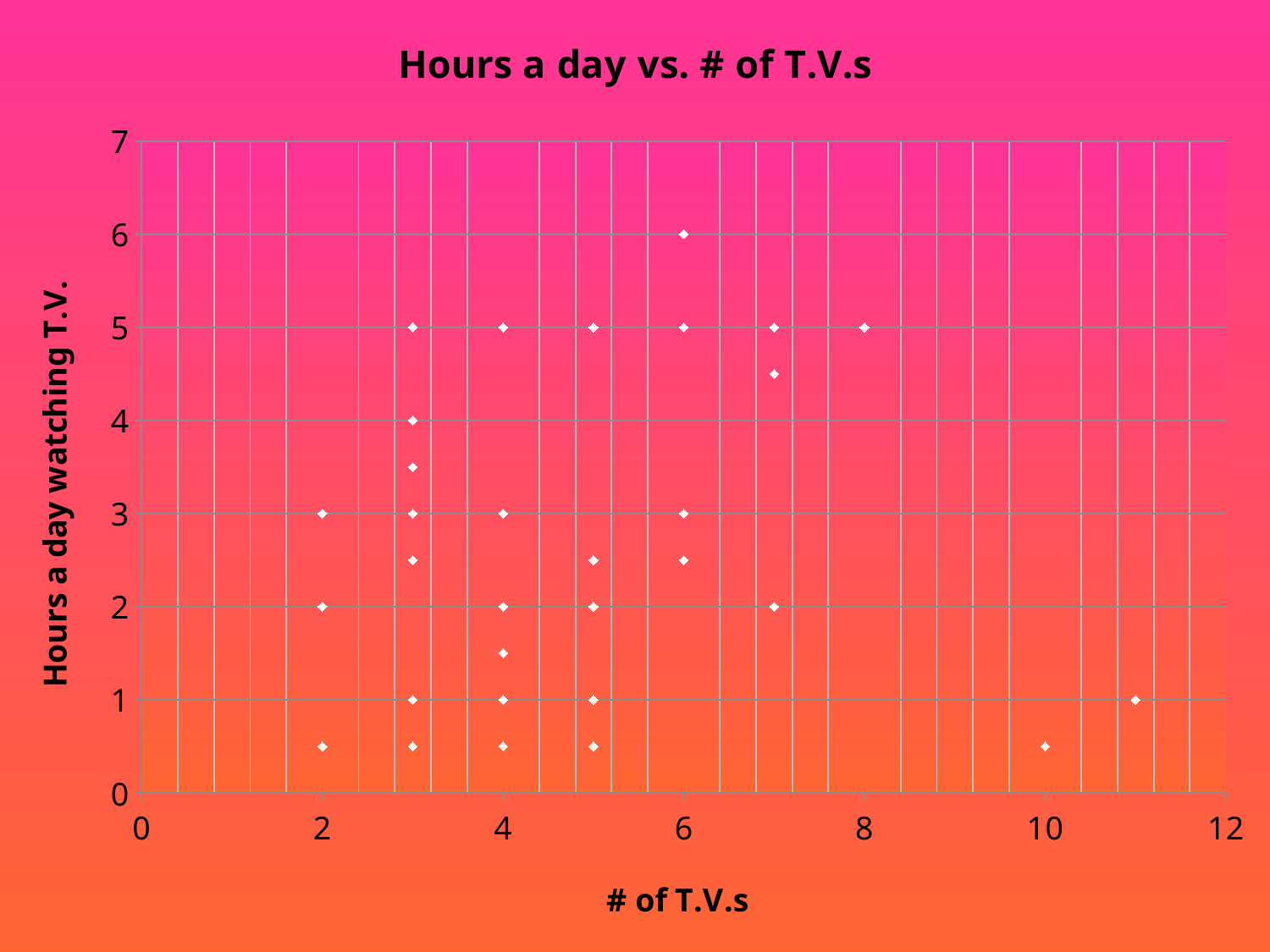
Which has more hours a day watching T.V.: the point at 8 T.V.s or the point at 11 T.V.s? 8 T.V.s Is the value for hours a day watching T.V. at 10 T.V.s greater or less than 1? less What is the highest number of hours a day watching T.V. plotted on the chart? 6 What is the title of the chart? Hours a day vs. # of T.V.s What is the maximum value shown on the horizontal axis? 12 How many hours a day watching T.V. is plotted for the point with 8 T.V.s? 5 How many hours a day watching T.V. is plotted for the point with 11 T.V.s? 1 What is the label of the vertical axis? Hours a day watching T.V. What kind of chart is shown on the slide? scatter plot How many T.V.s does the household with the highest hours a day watching T.V. (6 hours) have? 6